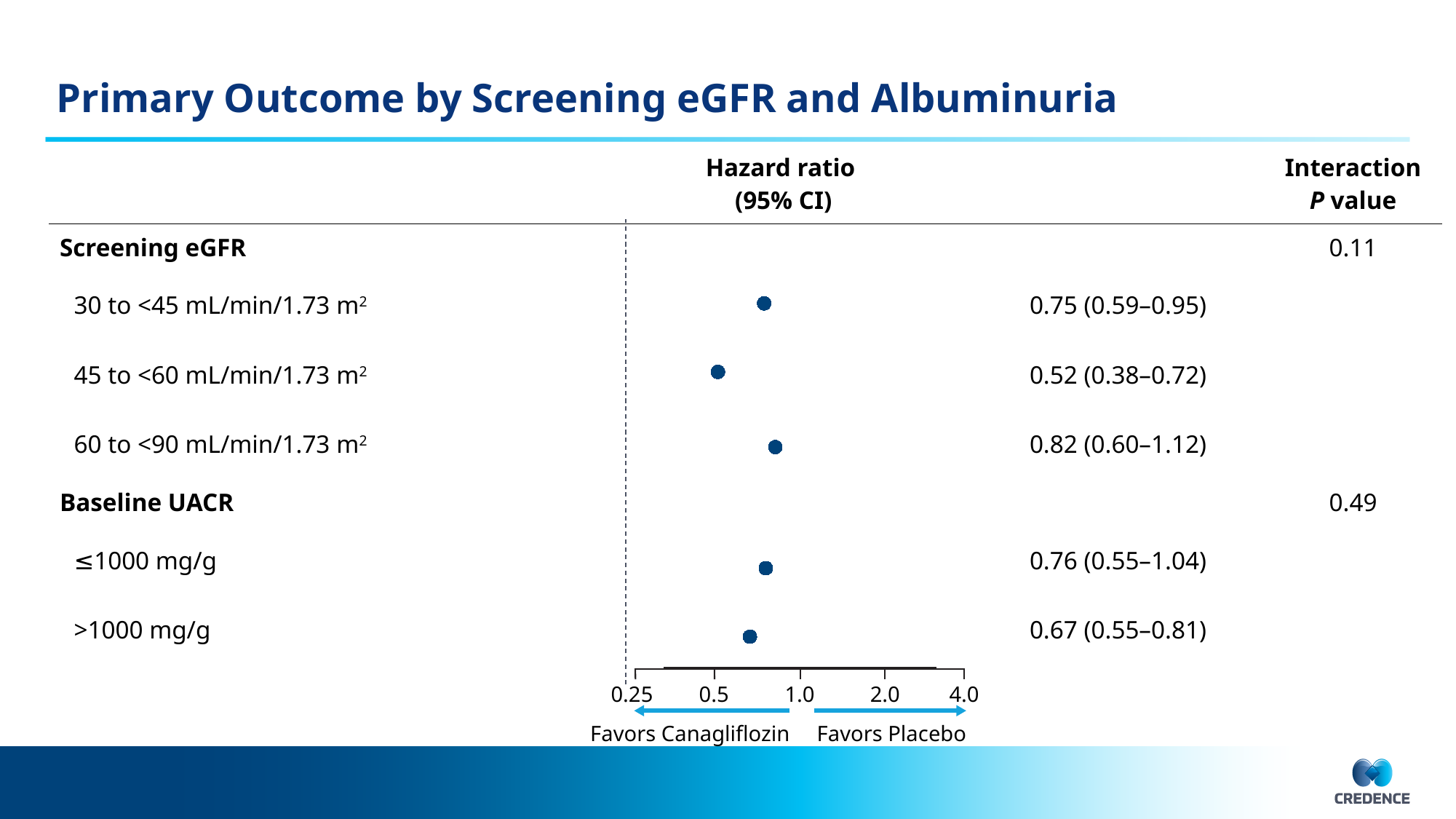
What is the 95% CI for the hazard ratio in the 30 to <45 mL/min/1.73 m² subgroup? 0.59–0.95 What is the hazard ratio for the baseline UACR >1000 mg/g subgroup? 0.67 Which has the larger hazard ratio: ≤1000 mg/g or >1000 mg/g? ≤1000 mg/g Is the hazard ratio for the 60 to <90 mL/min/1.73 m² subgroup greater or less than 1.0? less Which subgroup has the highest hazard ratio? 60 to <90 mL/min/1.73 m² How many subgroup points are plotted on the chart? 5 Which subgroup has the lowest hazard ratio? 45 to <60 mL/min/1.73 m² What is the hazard ratio for the screening eGFR subgroup 45 to <60 mL/min/1.73 m²? 0.52 What does the left side of the x axis (below 1.0) favor according to the label? Favors Canagliflozin What is the interaction P value for baseline UACR? 0.49 What is the difference between the hazard ratios for the 60 to <90 and 45 to <60 mL/min/1.73 m² subgroups? 0.30 What is the interaction P value for screening eGFR? 0.11